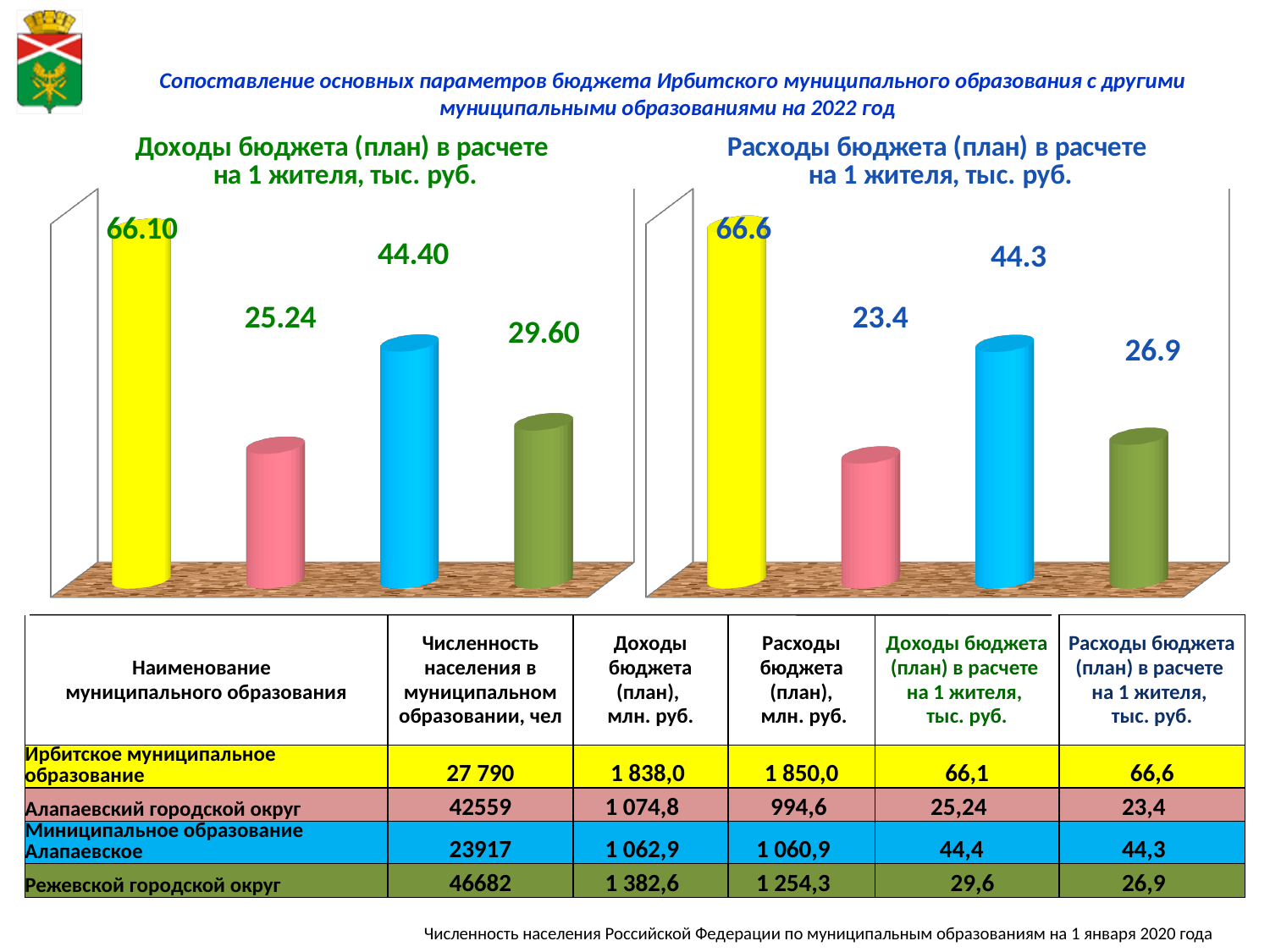
In the left chart (Доходы бюджета), which bar has the highest value? The yellow bar (66.10) In the chart titled "Доходы бюджета (план) в расчете на 1 жителя, тыс. руб.", what is the value shown on the yellow bar? 66.10 How many bars are plotted in the chart titled "Расходы бюджета (план) в расчете на 1 жителя, тыс. руб."? 4 In the right chart (Расходы бюджета), which bar has the lowest value? The pink bar (23.4) What is the title of the chart on the right side of the slide? Расходы бюджета (план) в расчете на 1 жителя, тыс. руб. In the right chart (Расходы бюджета), what value is labelled on the green bar? 26.9 In the right chart (Расходы бюджета), what is the difference between the green bar and the pink bar? 3.5 In the left chart (Доходы бюджета), what is the difference between the yellow bar and the blue bar? 21.70 In the left chart (Доходы бюджета), which is larger: the green bar or the pink bar? The green bar (29.60) In the left chart (Доходы бюджета), what value is labelled on the pink bar? 25.24 In the chart titled "Расходы бюджета (план) в расчете на 1 жителя, тыс. руб.", what is the value shown on the blue bar? 44.3 What type of chart is the left chart titled "Доходы бюджета (план) в расчете на 1 жителя, тыс. руб."? Bar chart